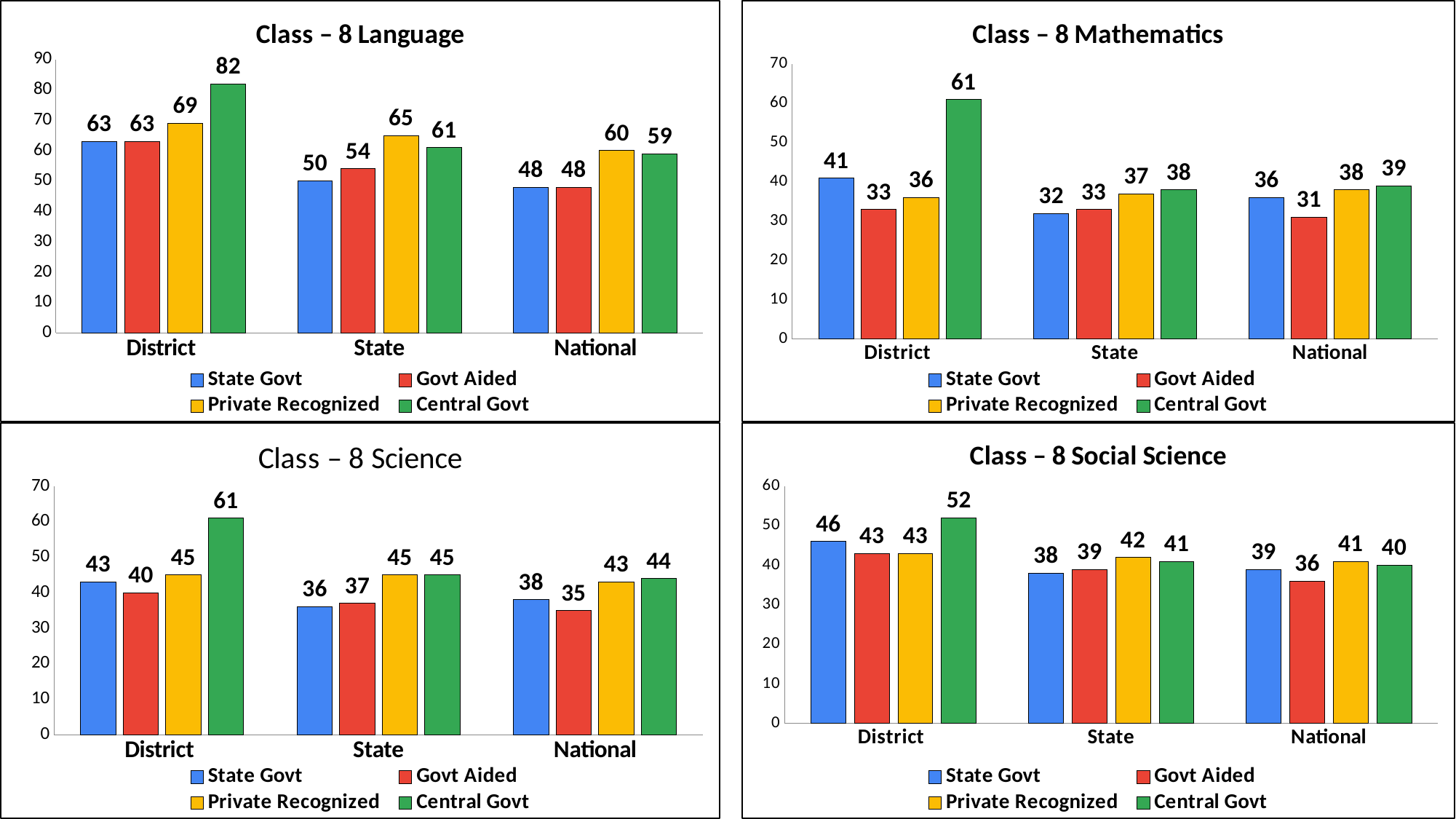
How many series does the legend list in the 'Class – 8 Social Science' chart? 4 In the 'Class – 8 Social Science' chart, which series has the lowest value in the National category? Govt Aided What kind of chart is 'Class – 8 Mathematics'? Bar chart In the 'Class – 8 Science' chart, which series has the highest value in the District category? Central Govt In the 'Class – 8 Social Science' chart, what is the difference between the Central Govt values for District and State? 11 In the 'Class – 8 Language' chart, how do the State Govt values change from District to State to National? They fall In the 'Class – 8 Language' chart, what is the difference between the Private Recognized and State Govt values in the State category? 15 How many categories are shown on the x axis of the 'Class – 8 Language' chart? 3 In the 'Class – 8 Mathematics' chart, what is the value for Govt Aided in the National category? 31 In the 'Class – 8 Mathematics' chart, which is larger in the District category: State Govt or Private Recognized? State Govt In the 'Class – 8 Language' chart, what is the value for Central Govt in the District category? 82 In the 'Class – 8 Science' chart, what is the value for Private Recognized in the National category? 43